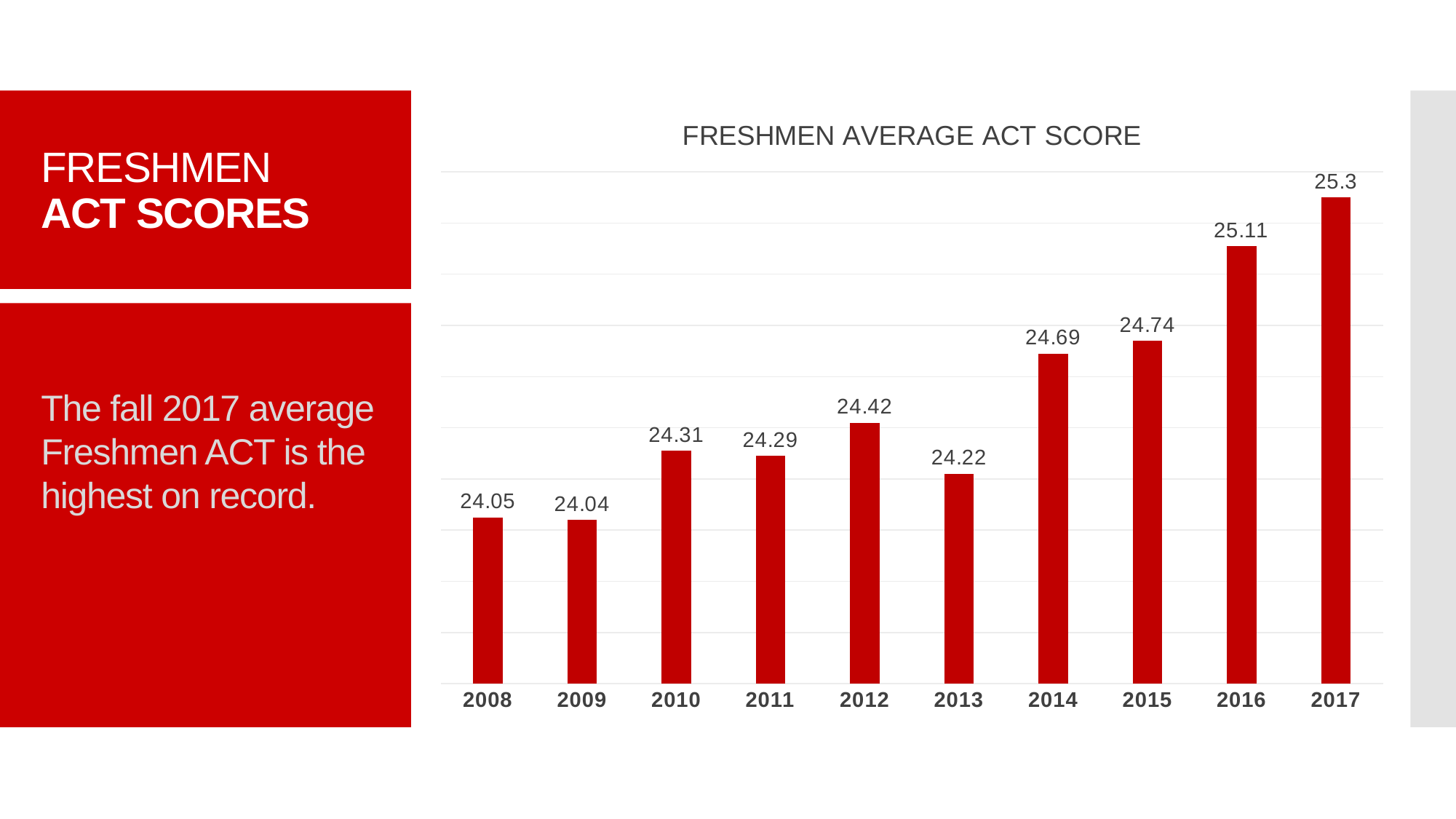
What is the difference between the 2017 and 2008 freshmen average ACT scores? 1.25 What is the freshmen average ACT score for 2008? 24.05 Do the freshmen average ACT scores generally rise or fall from 2013 to 2017? Rise What is the freshmen average ACT score for 2016? 25.11 What kind of chart is shown on the slide? Bar chart Which year has the highest freshmen average ACT score? 2017 What is the freshmen average ACT score for 2012? 24.42 Which year has the lowest freshmen average ACT score? 2009 Which year has a higher freshmen average ACT score, 2013 or 2014? 2014 How many years are shown on the chart? 10 What is the title of the chart? FRESHMEN AVERAGE ACT SCORE What is the difference between the 2015 and 2014 freshmen average ACT scores? 0.05